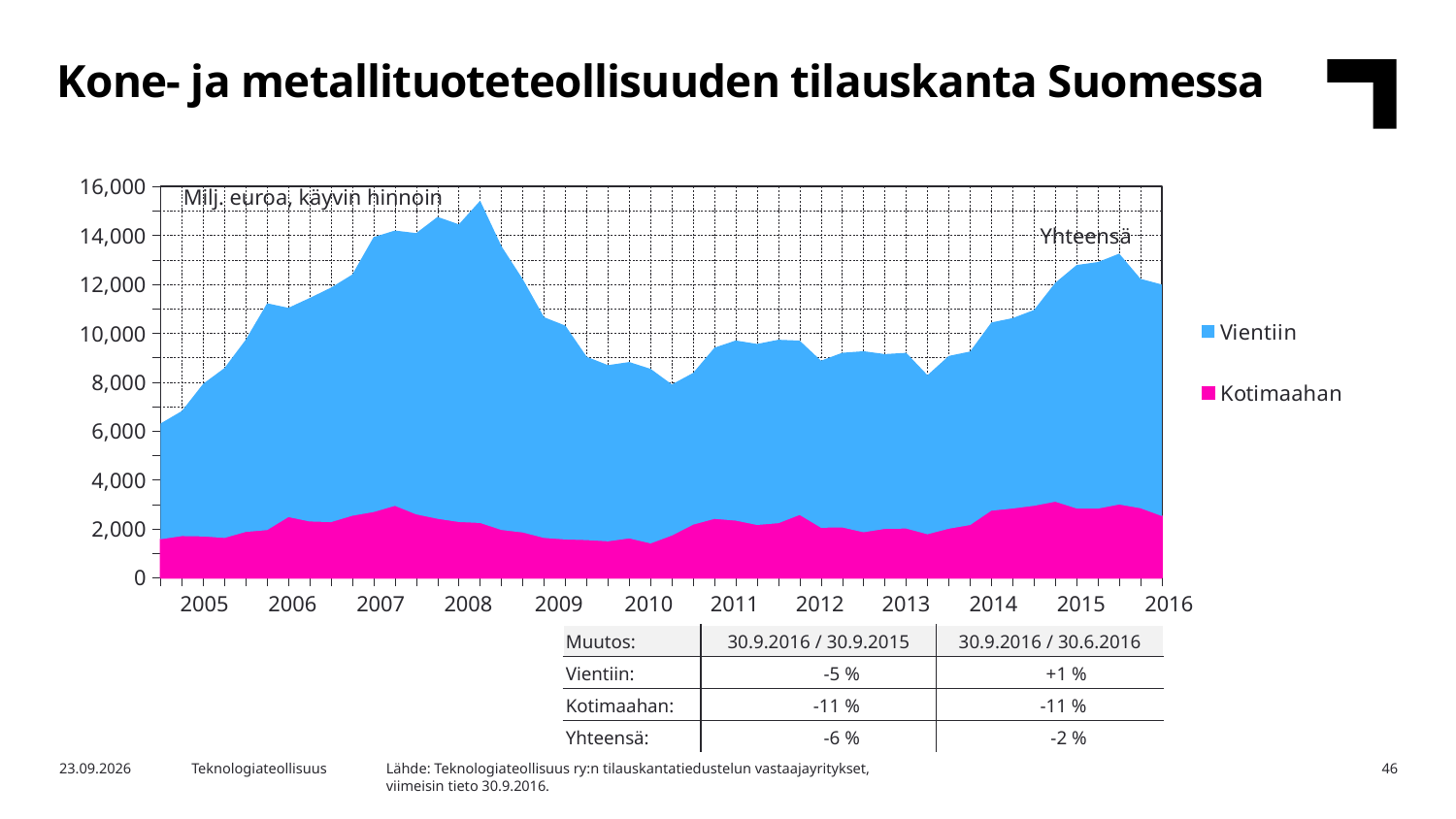
Which two series are listed in the chart legend? Vientiin and Kotimaahan Is the total order backlog at the start of 2005 greater or less than 8,000? less Which is larger, the total order backlog in 2008 or in 2016? 2008 According to the table below the chart, what is the change in Vientiin for 30.9.2016 / 30.9.2015? -5 % Is the Kotimaahan value in 2015 greater or less than 4,000? less In which year is the total order backlog at its lowest? 2005 Does the total order backlog rise or fall between 2008 and 2009? fall Is the peak total value in 2008 greater or less than 14,000? greater What kind of chart is shown on the slide? Stacked area chart What unit is stated in the chart's label at the top left of the plot area? Milj. euroa, käyvin hinnoin How many series does the chart legend list? 2 In which year does the total order backlog (Yhteensä) reach its highest peak? 2008